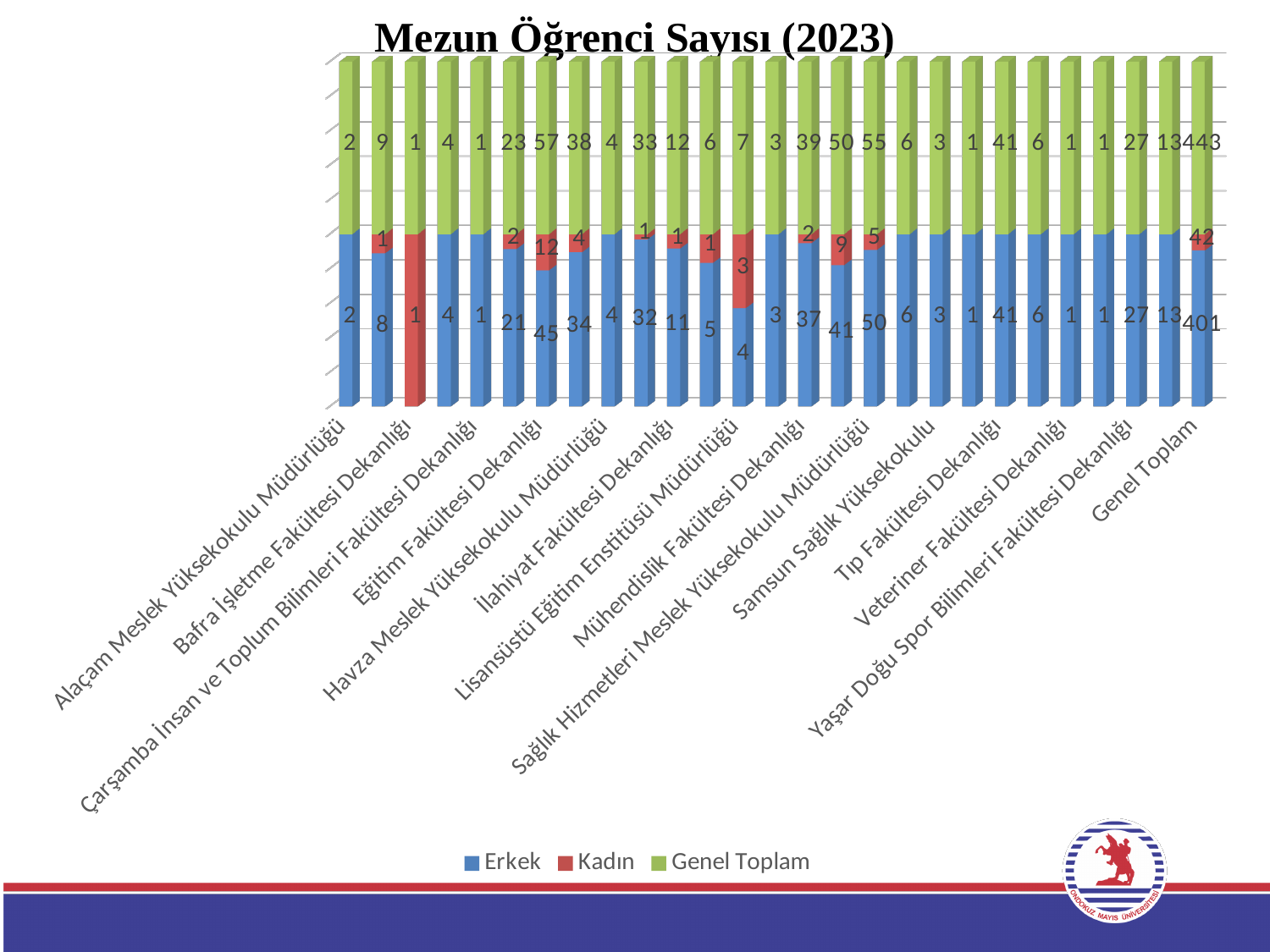
What is the Genel Toplam value for the Genel Toplam category? 443 How many series does the legend list? 3 What is the Kadın value for the Genel Toplam category? 42 What is the Erkek value for Eğitim Fakültesi Dekanlığı? 45 What is the Genel Toplam value for Tıp Fakültesi Dekanlığı? 41 What is the Kadın value for Eğitim Fakültesi Dekanlığı? 12 What kind of chart is shown on the slide? Stacked bar chart What is the Erkek value for the Genel Toplam category? 401 Which has a larger Genel Toplam value, Eğitim Fakültesi Dekanlığı or Mühendislik Fakültesi Dekanlığı? Eğitim Fakültesi Dekanlığı Which series is shown in green in the legend? Genel Toplam What is the difference between the Erkek and Kadın values for the Genel Toplam category? 359 What is the title of the chart? Mezun Öğrenci Sayısı (2023)